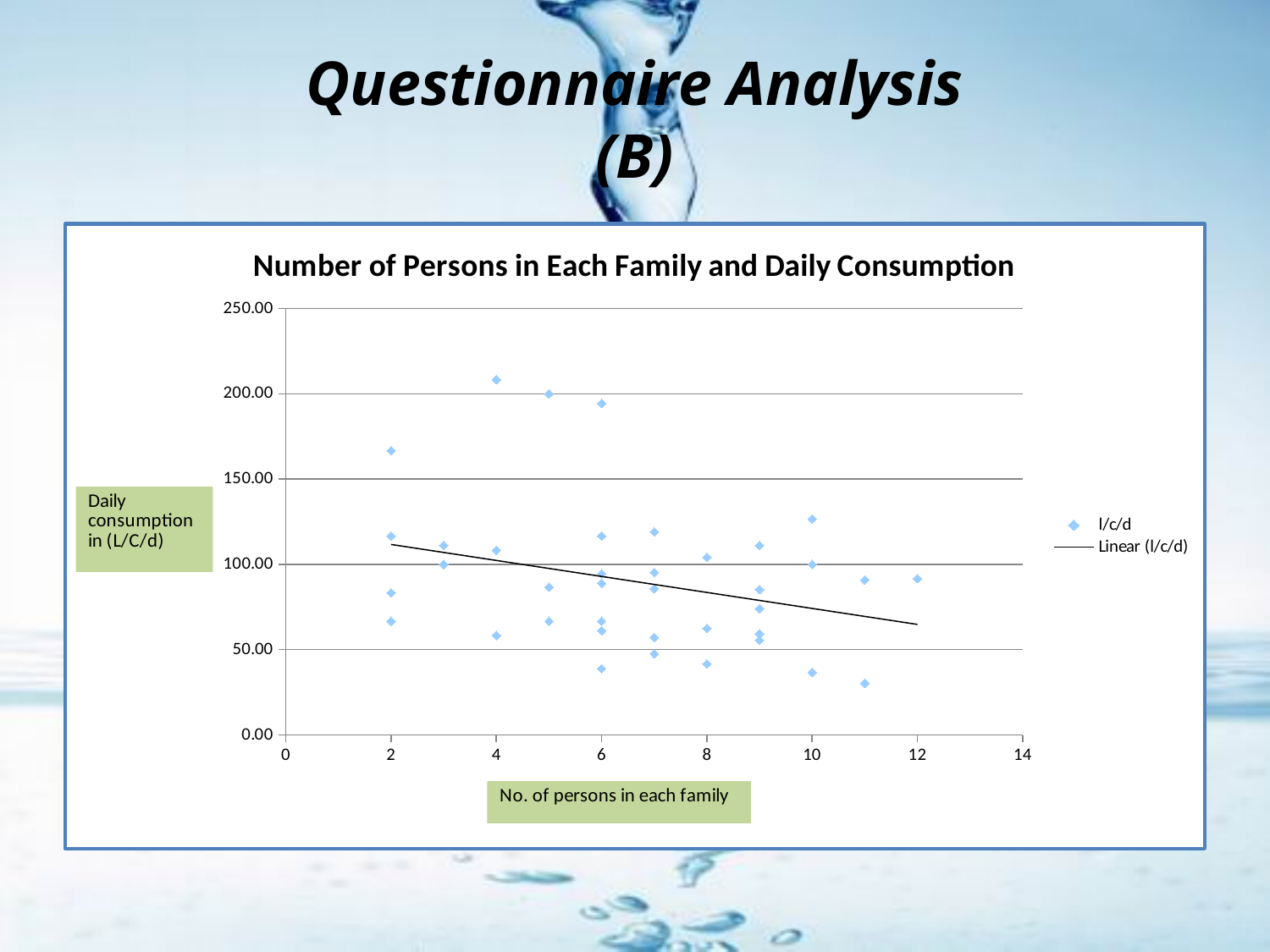
How many entries does the chart's legend list? 2 Is the highest plotted daily consumption value greater or less than 150.00? greater Is the value of the linear trendline at 2 persons greater or less than 100.00? greater What is the maximum value shown on the y axis? 250.00 Is the lowest plotted daily consumption value greater or less than 50.00? less Does the linear trendline rise or fall as the number of persons in each family increases? Fall What is the label of the x axis? No. of persons in each family What is the title of the chart? Number of Persons in Each Family and Daily Consumption What kind of chart is shown on the slide? Scatter chart